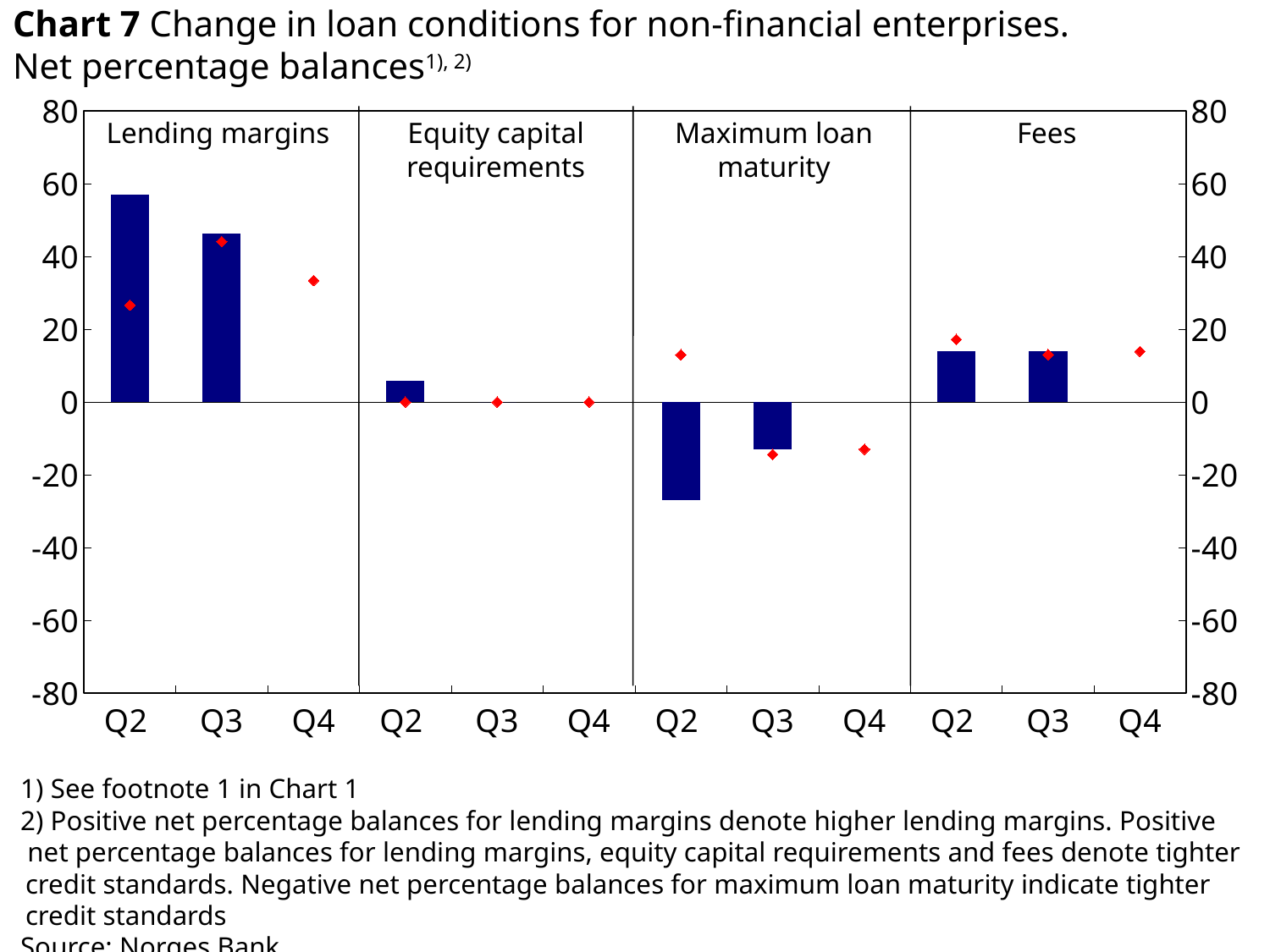
What is the title of the chart? Chart 7 Change in loan conditions for non-financial enterprises. Net percentage balances Is the Q2 bar for Maximum loan maturity greater or less than -20? less In the Lending margins panel, which bar is taller, Q2 or Q3? Q2 Is the Q2 bar for Fees greater or less than 0? greater Is the Q2 bar for Equity capital requirements greater or less than 20? less Do the bars for Lending margins rise or fall from Q2 to Q3? Fall How many loan condition categories (panels) does the chart show? 4 In the Maximum loan maturity panel, which bar has the higher value, Q2 or Q3? Q3 Which bar in the chart has the lowest value? Maximum loan maturity, Q2 Which loan condition category has the tallest bar in the chart? Lending margins What kind of chart is shown on the slide? Bar chart